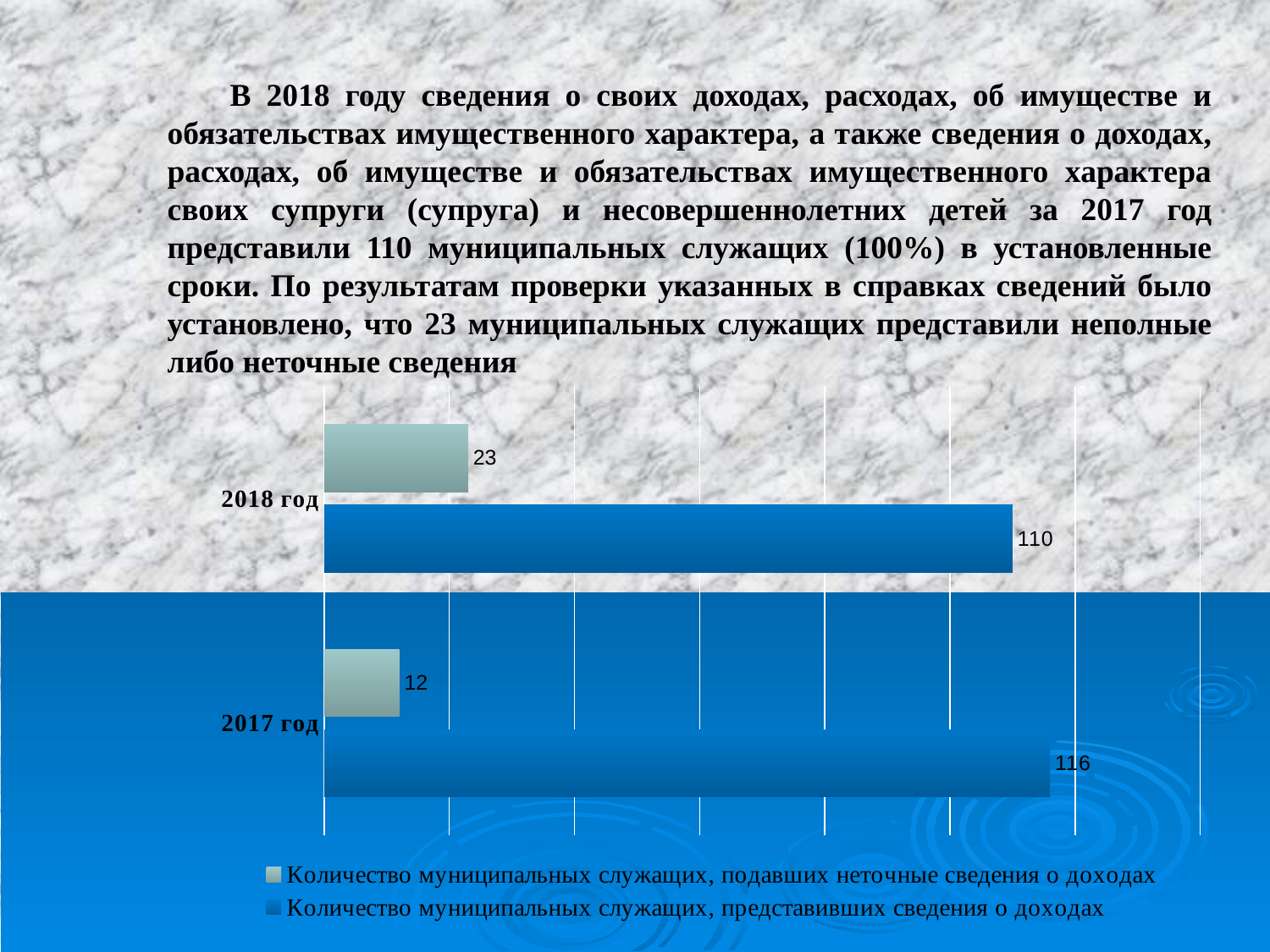
Which year has the higher value for 'Количество муниципальных служащих, представивших сведения о доходах'? 2017 год How many categories (years) are shown on the chart? 2 What kind of chart is shown on the slide? bar chart Which is larger: the value for 'подавших неточные сведения' in 2018 год or in 2017 год? 2018 год What is the difference between the number of municipal employees who submitted income information in 2017 год and in 2018 год? 6 What is the value for 'Количество муниципальных служащих, подавших неточные сведения о доходах' in 2017 год? 12 What is the value for 'Количество муниципальных служащих, представивших сведения о доходах' in 2017 год? 116 What is the difference between the number of municipal employees who submitted inaccurate income information in 2018 год and in 2017 год? 11 What is the value for 'Количество муниципальных служащих, подавших неточные сведения о доходах' in 2018 год? 23 How many series does the legend list? 2 What is the value for 'Количество муниципальных служащих, представивших сведения о доходах' in 2018 год? 110 Which year has the lower value for 'Количество муниципальных служащих, подавших неточные сведения о доходах'? 2017 год